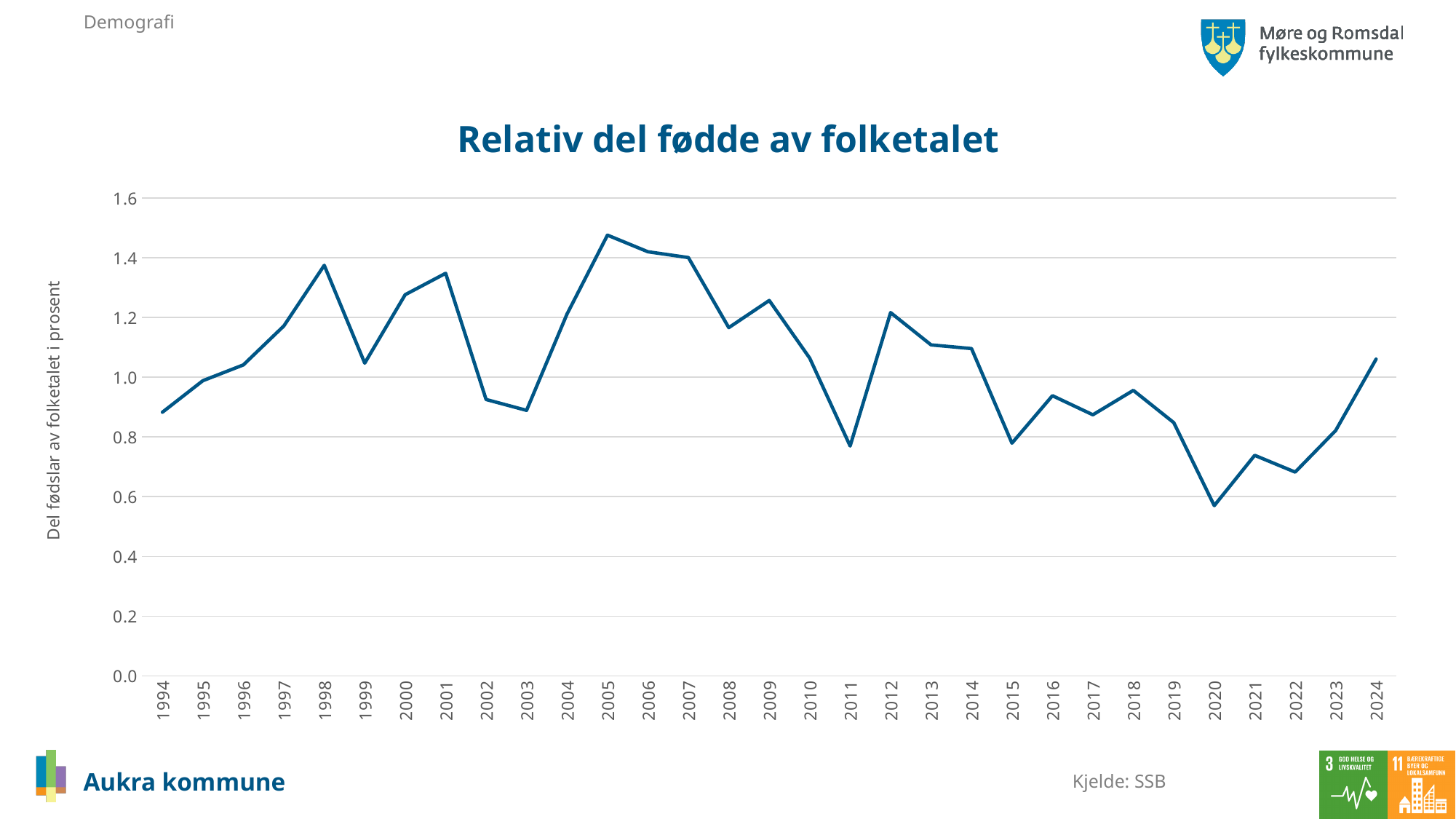
Is the value for 2005 greater or less than 1.4? greater Is the value for 2022 greater or less than 0.8? less What is the title of the chart? Relativ del fødde av folketalet In which year is the value highest? 2005 In which year is the value lowest? 2020 How many years are plotted along the x axis of the chart? 31 Is the value for 2020 greater or less than 0.8? less What is the label on the vertical axis of the chart? Del fødslar av folketalet i prosent What kind of chart is shown on the slide? line chart Which year has the larger value, 1998 or 1999? 1998 Do the values rise or fall from 2020 to 2024? rise